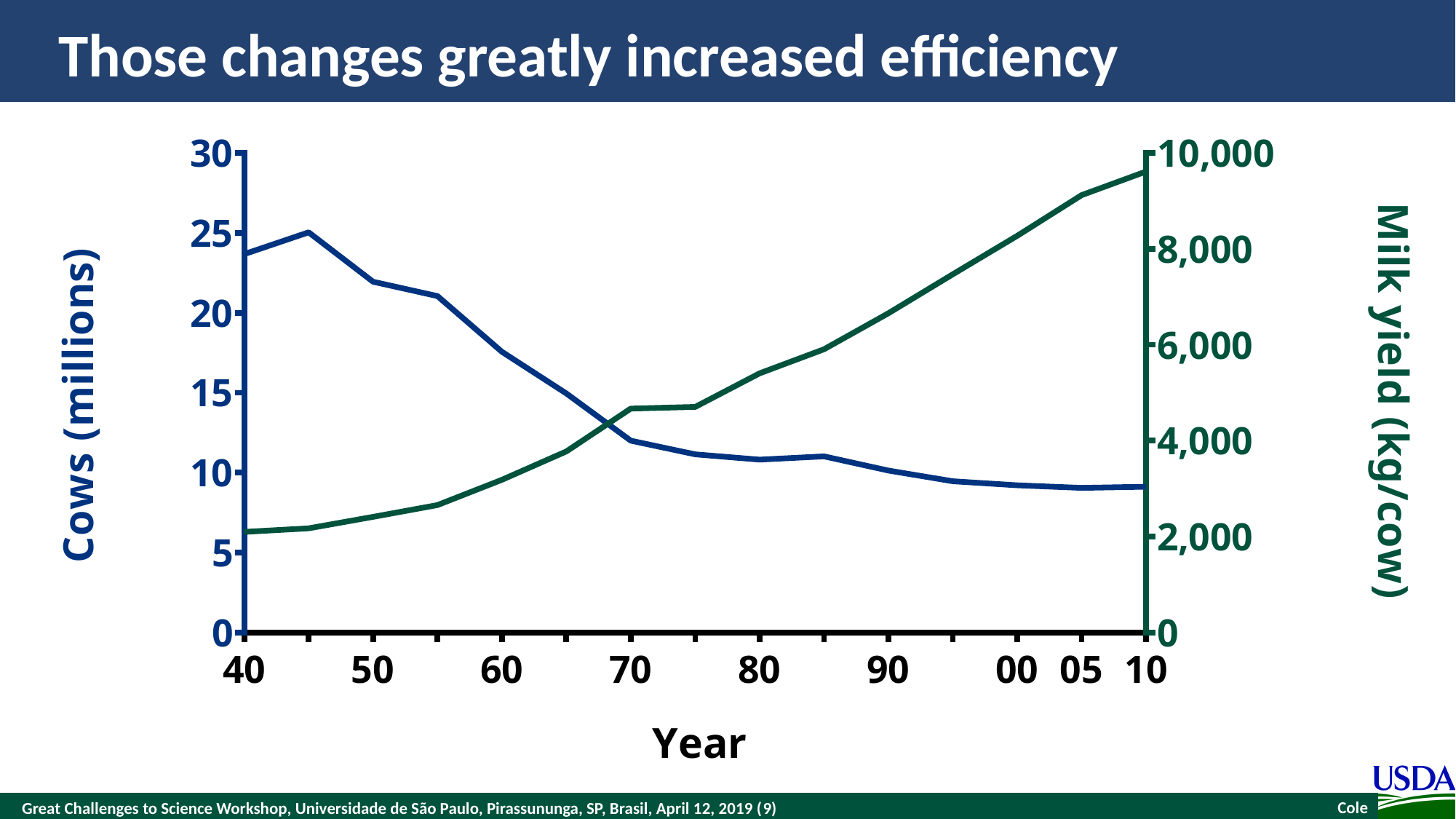
Is the Cows (millions) value for year 60 greater or less than 20? less Is the Milk yield (kg/cow) value for year 10 greater or less than 8,000? greater What is the label of the right vertical axis? Milk yield (kg/cow) What is the label of the left vertical axis? Cows (millions) Is the Cows (millions) value for year 10 greater or less than 10? less In which year is the Milk yield (kg/cow) value highest? 10 In which year is the Milk yield (kg/cow) value lowest? 40 Does the Milk yield (kg/cow) line rise or fall overall from 40 to 10 along the x axis? rise Does the Cows (millions) line rise or fall overall from 40 to 10 along the x axis? fall How many data series (lines) are plotted on the chart? 2 What kind of chart is shown on the slide? line chart